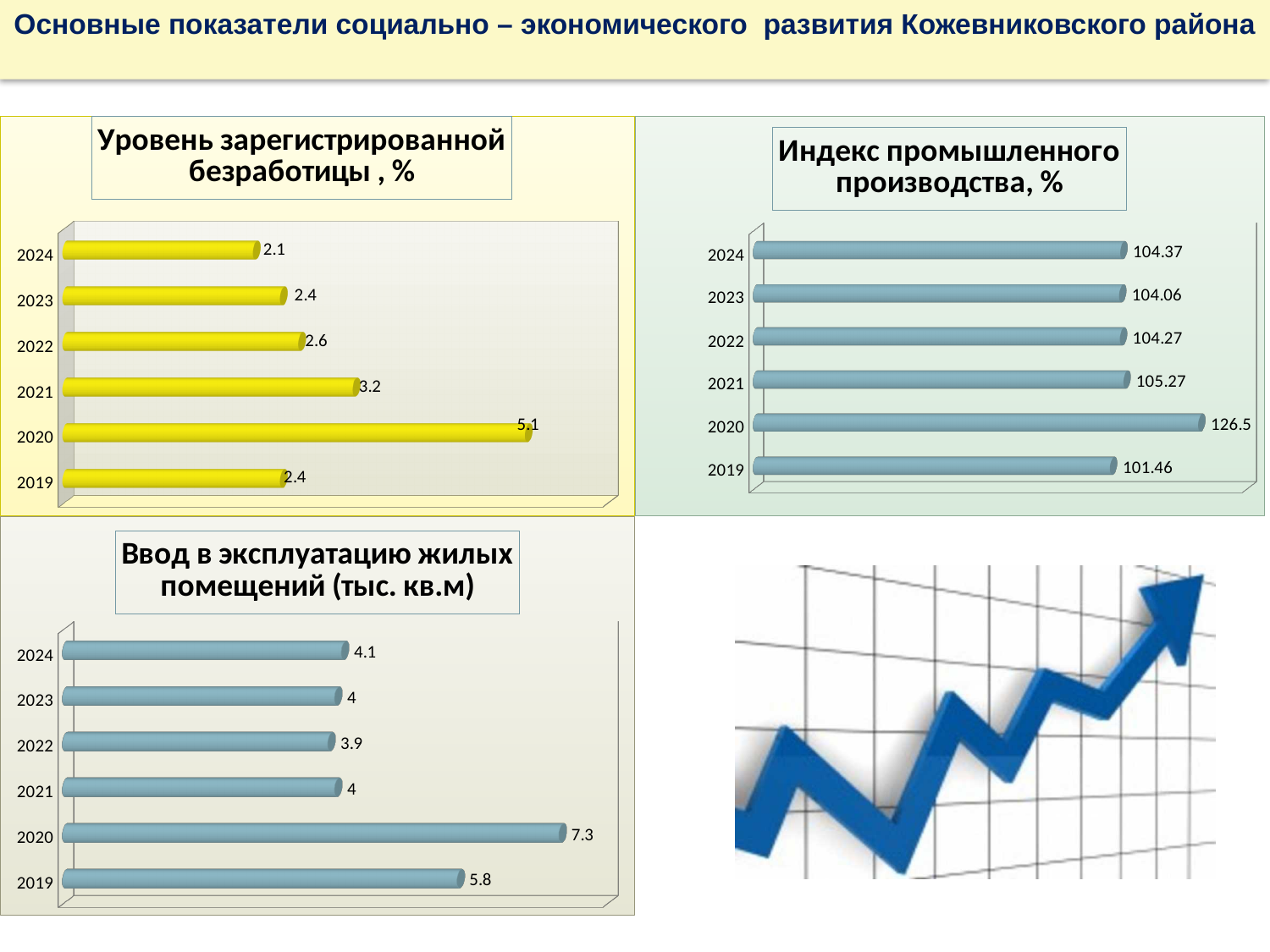
In the chart 'Индекс промышленного производства, %', how many years are shown? 6 In the chart 'Индекс промышленного производства, %', which year has the highest value? 2020 In the chart 'Индекс промышленного производства, %', what is the value for 2021? 105.27 In the chart 'Уровень зарегистрированной безработицы, %', which year has the lowest value? 2024 In the chart 'Ввод в эксплуатацию жилых помещений (тыс. кв.м)', which year has the highest value? 2020 What kind of chart is 'Уровень зарегистрированной безработицы, %'? Bar chart In the chart 'Ввод в эксплуатацию жилых помещений (тыс. кв.м)', which is larger, the value for 2024 or the value for 2022? 2024 In the chart 'Индекс промышленного производства, %', which year has the lowest value? 2019 In the chart 'Ввод в эксплуатацию жилых помещений (тыс. кв.м)', what is the difference between the values for 2020 and 2019? 1.5 In the chart 'Уровень зарегистрированной безработицы, %', what is the difference between the values for 2020 and 2021? 1.9 In the chart 'Уровень зарегистрированной безработицы, %', what is the value for 2020? 5.1 In the chart 'Ввод в эксплуатацию жилых помещений (тыс. кв.м)', what is the value for 2019? 5.8